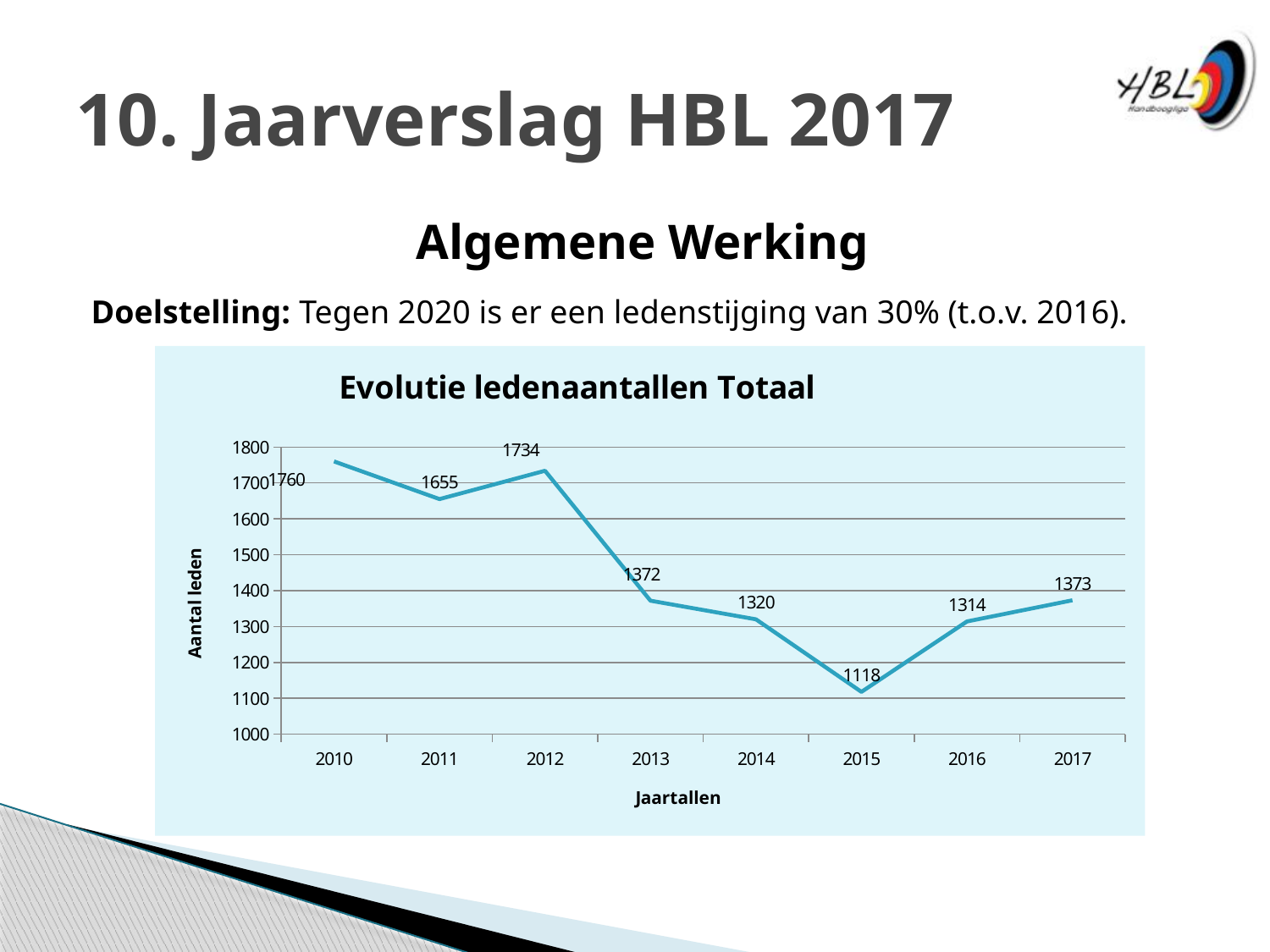
What is the value for 2010? 1760 What is the difference between the values for 2017 and 2016? 59 What is the value for 2015? 1118 What is the difference between the values for 2012 and 2013? 362 How many years are plotted on the x axis? 8 What is the value for 2017? 1373 Which is larger, the value for 2011 or the value for 2012? 2012 What kind of chart is shown? line chart Which year has the highest number of members? 2010 Which year has the lowest number of members? 2015 Is the value for 2014 greater or less than 1400? less What is the title of the chart? Evolutie ledenaantallen Totaal